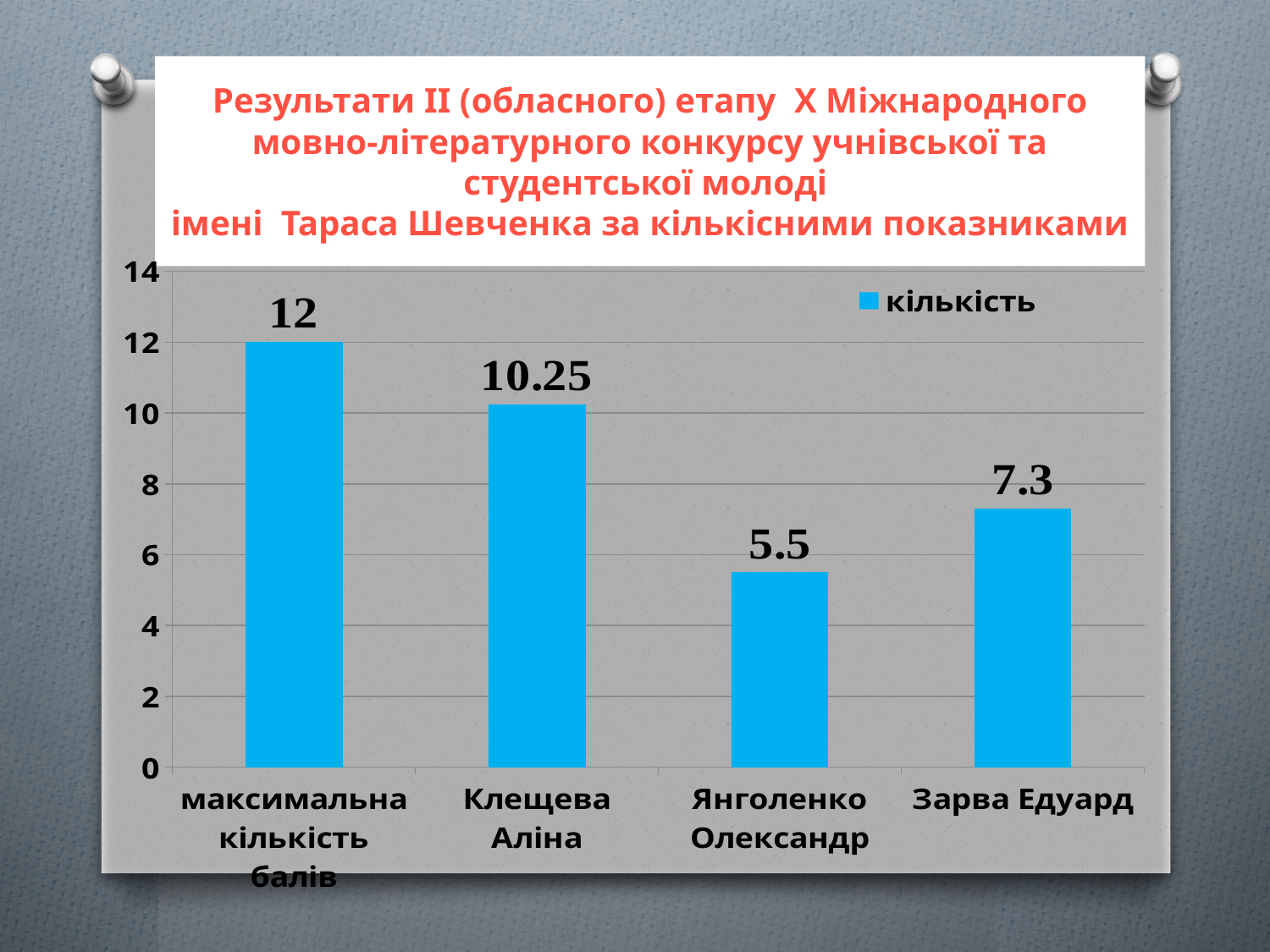
What is the value for Зарва Едуард? 7.3 What kind of chart is shown on the slide? bar chart What is the difference between the value for Клещева Аліна and the value for Зарва Едуард? 2.95 Which is larger, the value for Зарва Едуард or the value for Янголенко Олександр? Зарва Едуард What is the value for максимальна кількість балів? 12 How many series does the legend list? 1 What is the value for Клещева Аліна? 10.25 What is the value for Янголенко Олександр? 5.5 How many categories are shown on the x axis? 4 Which category has the highest value? максимальна кількість балів Which category has the lowest value? Янголенко Олександр What is the difference between the maximum score (максимальна кількість балів) and the value for Янголенко Олександр? 6.5